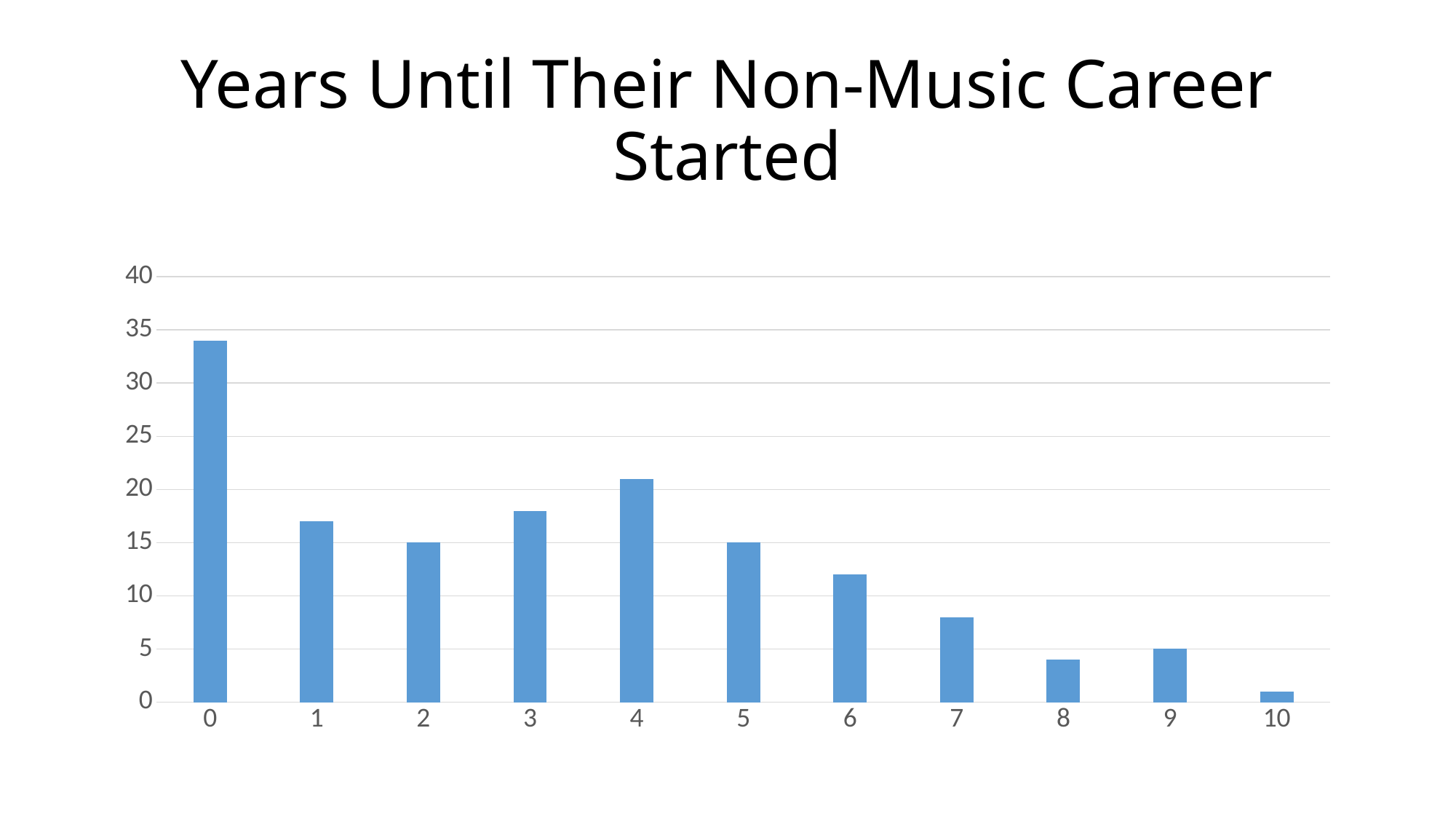
What is the value for category 9? 5 Which category has the highest bar? 0 Which is larger, the value for category 4 or the value for category 6? 4 Is the value for category 0 greater or less than 30? greater What is the title of the chart? Years Until Their Non-Music Career Started Do the values generally rise or fall from category 4 to category 10? fall Which category has the lowest bar? 10 How many categories are shown on the x axis? 11 What is the value for category 2? 15 What kind of chart is shown on the slide? bar chart Is the value for category 7 greater or less than 10? less Is the value for category 4 greater or less than 20? greater